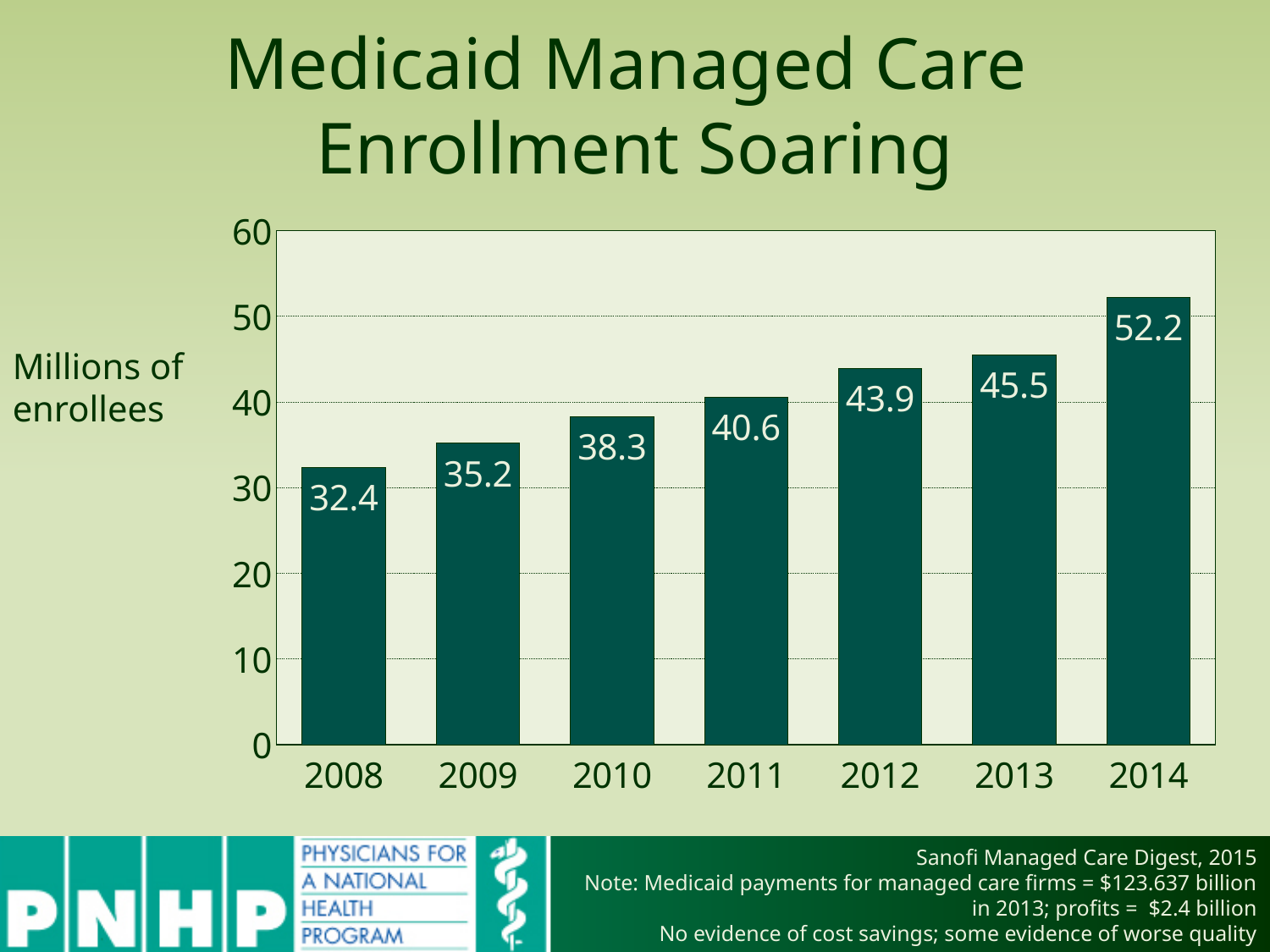
What kind of chart is shown on the slide? bar chart How many years are shown on the x axis? 7 Do the values rise or fall from 2008 to 2014? rise What is the value for 2011? 40.6 What is the difference between the values for 2013 and 2012? 1.6 What is the value for 2008? 32.4 Which year has the lowest value? 2008 Which year has the highest value? 2014 Which is larger, the value for 2010 or the value for 2012? 2012 What is the value for 2014? 52.2 What is the difference between the values for 2014 and 2008? 19.8 Is the value for 2013 greater or less than 40? greater